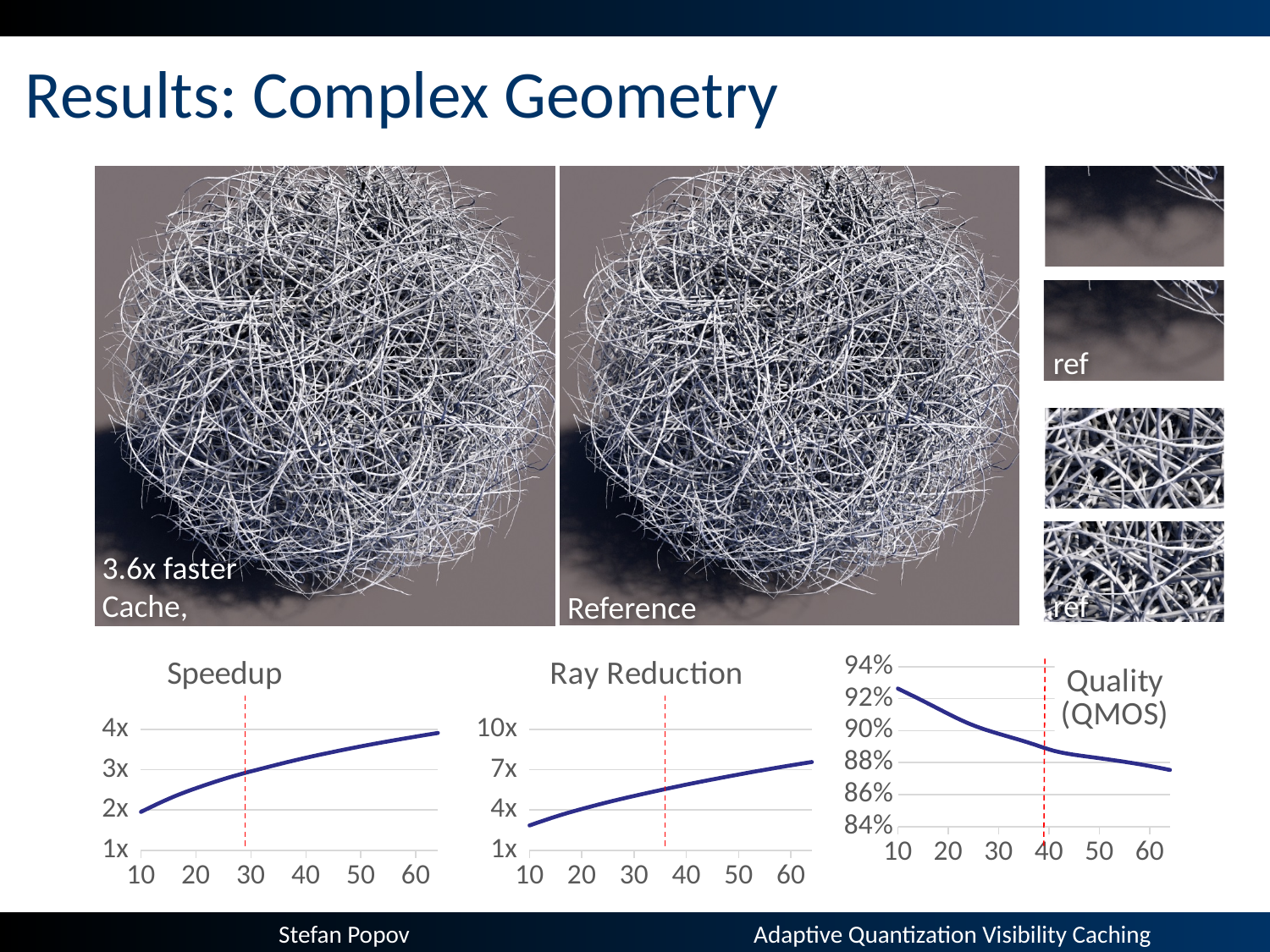
In the Speedup chart, do the values rise or fall as the x axis increases from 10 to 60? rise In the Quality (QMOS) chart, is the value at x = 60 greater or less than 90%? less What kind of chart is the Speedup chart? line chart In the Ray Reduction chart, is the value at x = 60 greater or less than 10x? less How many charts are shown on the slide? 3 In the Ray Reduction chart, do the values rise or fall along the x axis? rise In the Speedup chart, is the value at x = 20 greater or less than 3x? less In the Quality (QMOS) chart, do the values rise or fall along the x axis? fall What is the title of the rightmost chart on the slide? Quality (QMOS)